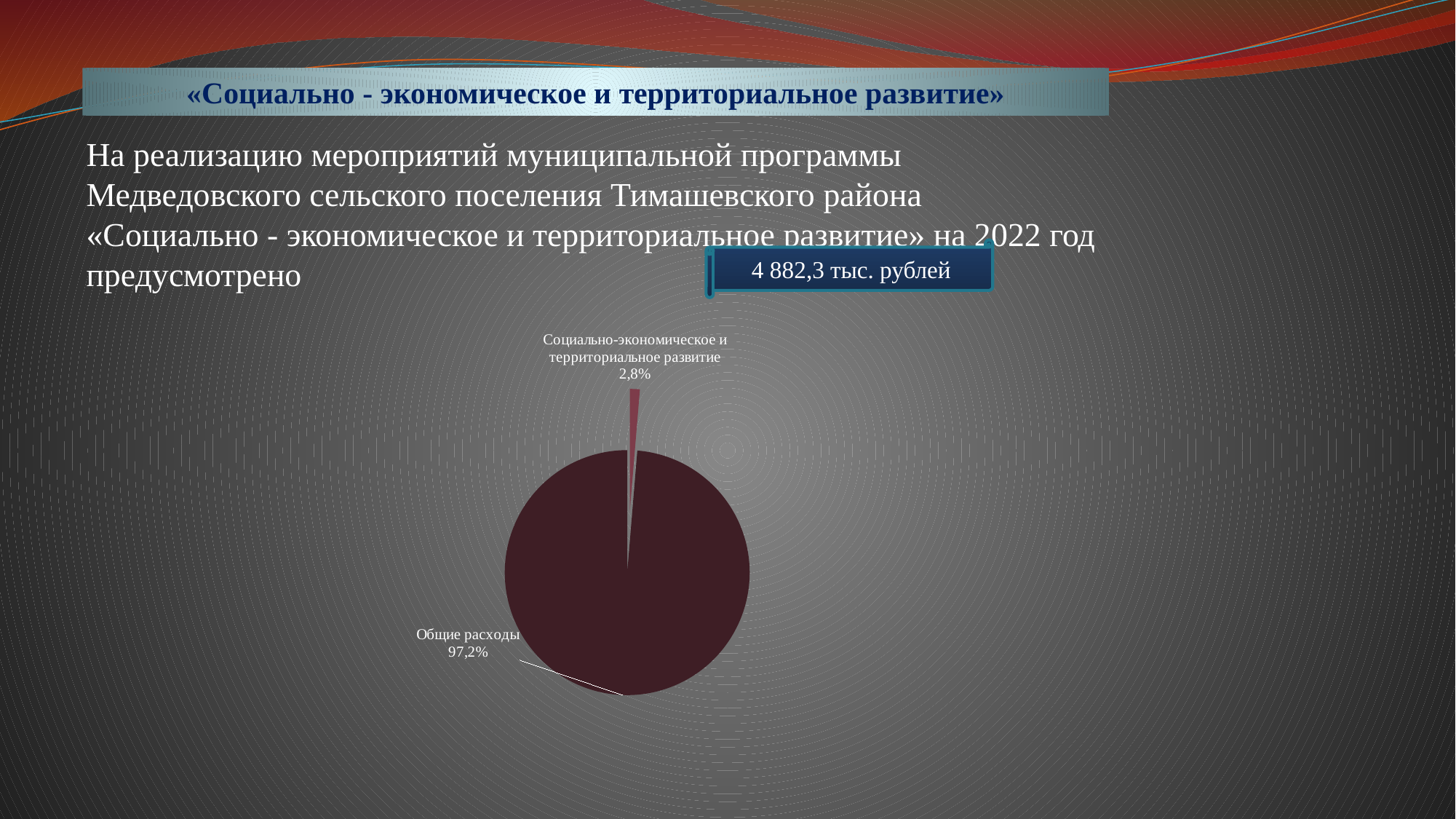
Which is larger: the "Общие расходы" slice or the "Социально-экономическое и территориальное развитие" slice? Общие расходы How many slices does the pie chart have? 2 Which slice of the pie is the largest? Общие расходы Is the share for "Социально-экономическое и территориальное развитие" greater or less than 10%? less What share of the pie does "Социально-экономическое и территориальное развитие" take? 2,8% Which slice of the pie is the smallest? Социально-экономическое и территориальное развитие Is the share for "Общие расходы" greater or less than 90%? greater What total amount in thousand rubles is shown in the box above the chart? 4 882,3 тыс. рублей What is the difference in percentage points between the "Общие расходы" slice and the "Социально-экономическое и территориальное развитие" slice? 94,4 What colour is the largest slice of the pie? dark brown What share of the pie does "Общие расходы" take? 97,2% What kind of chart is shown on the slide? pie chart